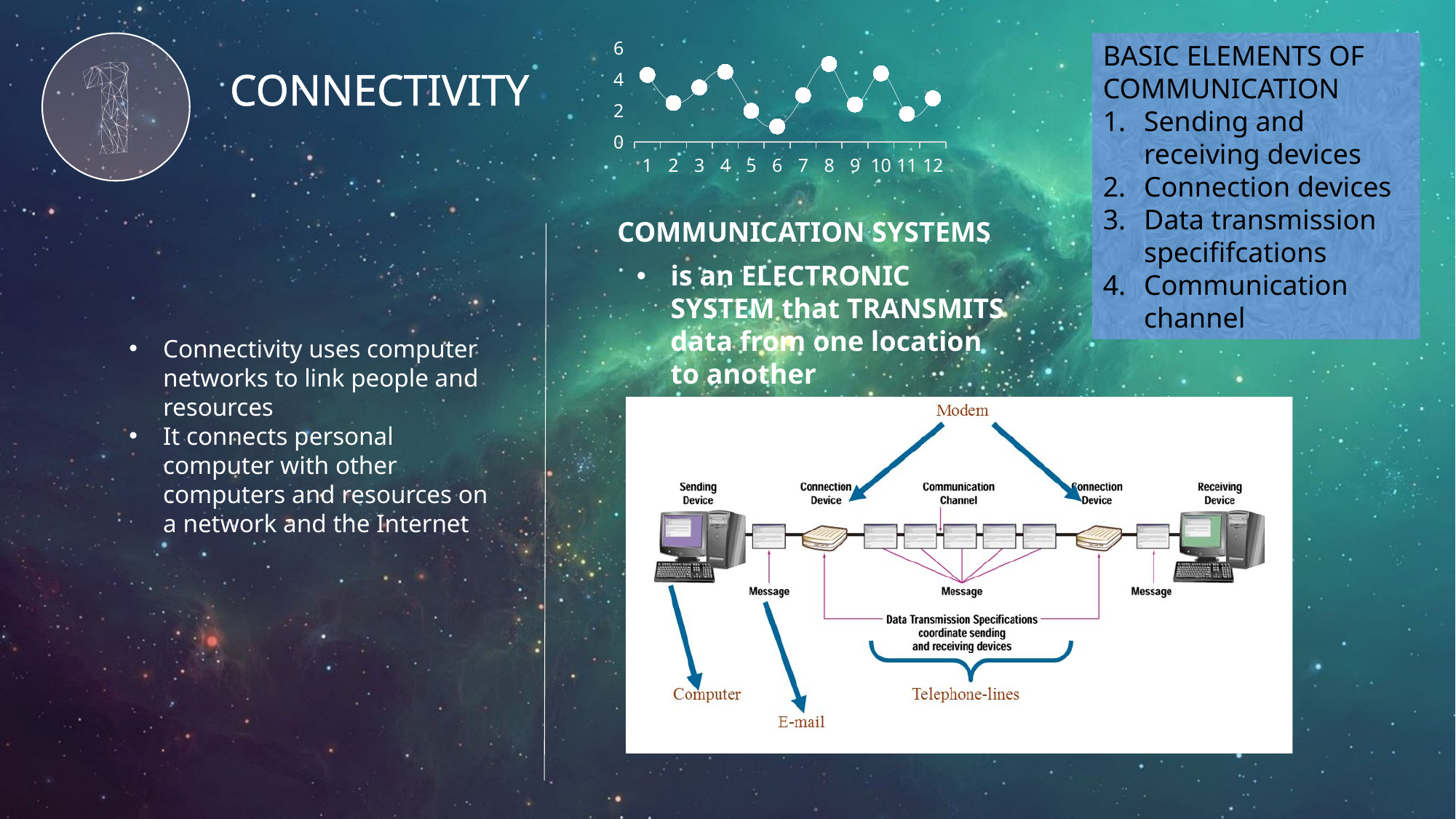
Is the value at category 6 on the line chart greater or less than 2? less Is the value at category 9 on the line chart greater or less than 4? less Does the line chart rise or fall from category 5 to category 6? fall On the line chart, which has the larger value: category 8 or category 9? 8 At which x-axis category does the line chart reach its lowest value? 6 Is the value at category 8 on the line chart greater or less than 4? greater What kind of chart is shown at the top of the slide? line chart What is the highest tick value shown on the y-axis of the line chart? 6 At which x-axis category does the line chart reach its highest value? 8 How many data points are plotted on the line chart? 12 On the line chart, which has the larger value: category 4 or category 5? 4